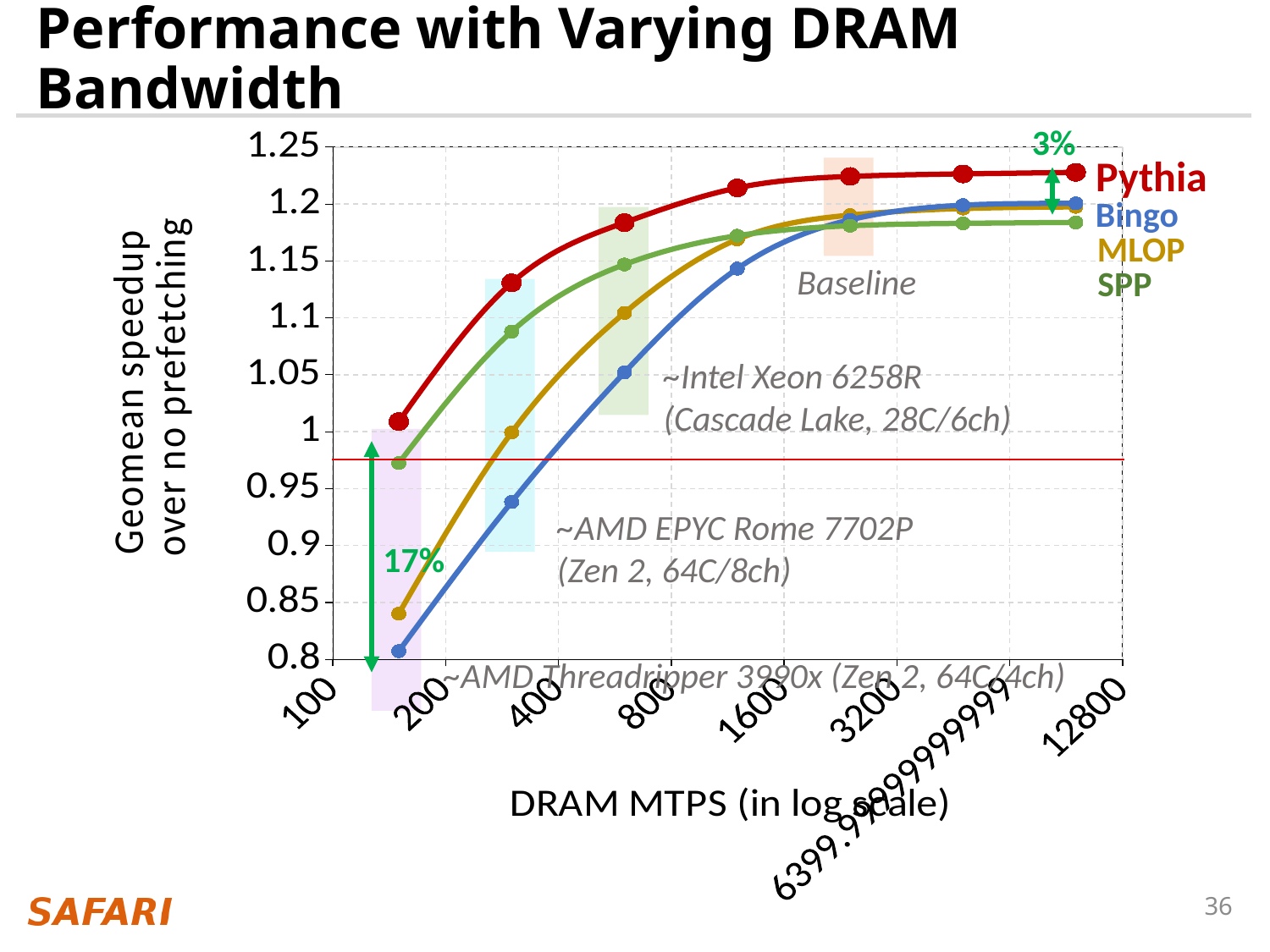
Is the value for Pythia at the highest DRAM bandwidth greater or less than 1.2? greater Is the value for SPP at the highest DRAM bandwidth greater or less than 1.2? less Which series has the lowest geomean speedup at the lowest DRAM bandwidth shown? Bingo How many series are plotted in the chart? 4 At the highest DRAM bandwidth, which series is higher, Pythia or Bingo? Pythia What kind of chart is shown on the slide? line chart What percentage gap is annotated between Pythia and the lowest series at the lowest DRAM bandwidth? 17% What is the title of the slide's chart? Performance with Varying DRAM Bandwidth Is the value for Bingo at the lowest DRAM bandwidth greater or less than 0.85? less Do the geomean speedup values rise or fall as DRAM MTPS increases along the x axis? rise Which series has the highest geomean speedup at the lowest DRAM bandwidth shown? Pythia At the second data point from the left, which series is higher, SPP or MLOP? SPP